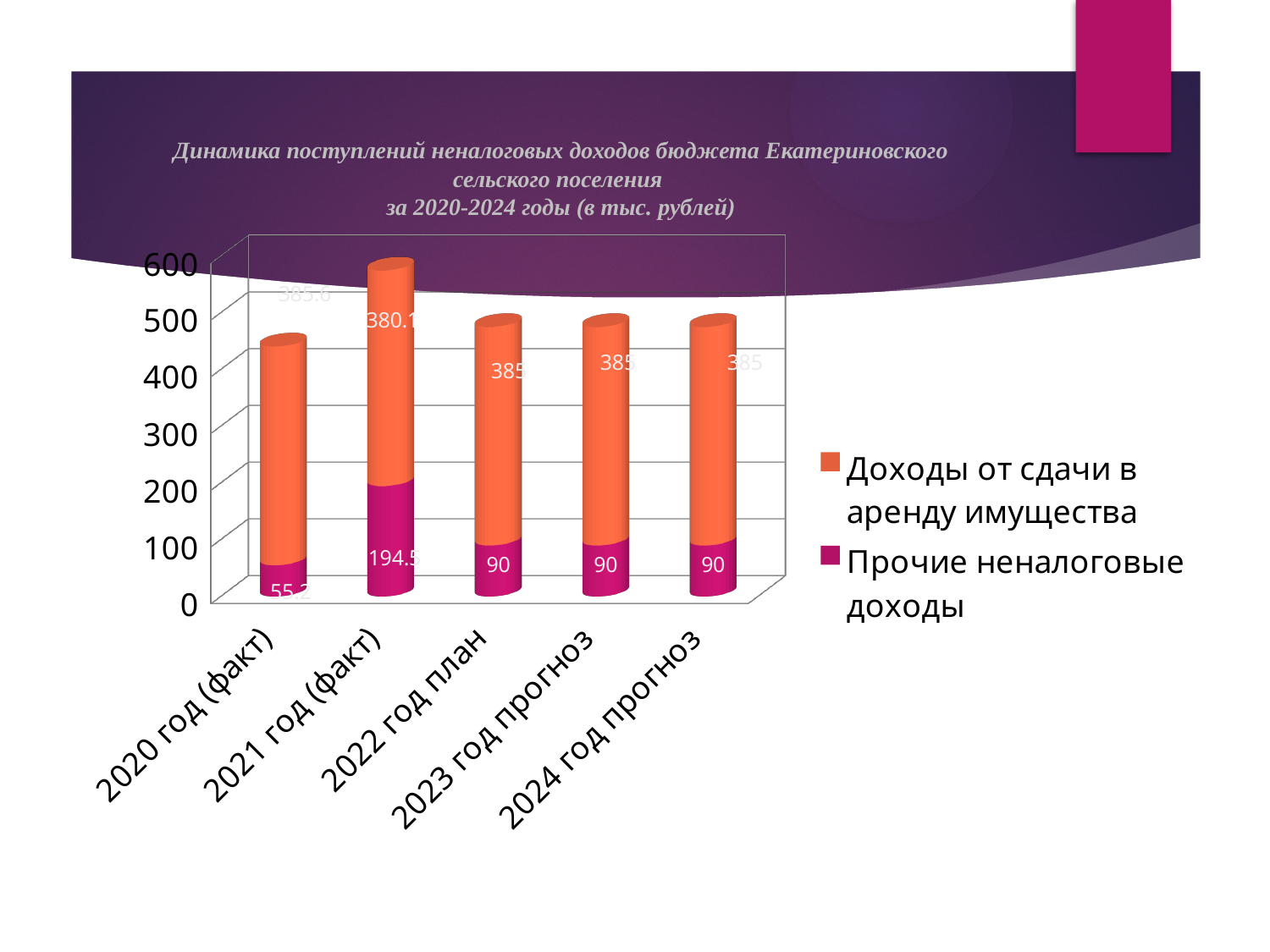
How many year categories are shown on the x axis? 5 What is the difference between Прочие неналоговые доходы in 2021 год (факт) and 2020 год (факт)? 139.3 What is the value of Прочие неналоговые доходы for 2021 год (факт)? 194.5 How many series does the legend list? 2 Which is larger: Прочие неналоговые доходы in 2021 год (факт) or in 2023 год прогноз? 2021 год (факт) What kind of chart is shown on the slide? Stacked bar chart What is the total of the stacked bar for 2022 год план? 475 What is the value of Доходы от сдачи в аренду имущества for 2021 год (факт)? 380.1 Which year has the highest value for Прочие неналоговые доходы? 2021 год (факт) Which year has the lowest value for Прочие неналоговые доходы? 2020 год (факт) What is the value of Доходы от сдачи в аренду имущества for 2022 год план? 385 What is the value of Прочие неналоговые доходы for 2020 год (факт)? 55.2